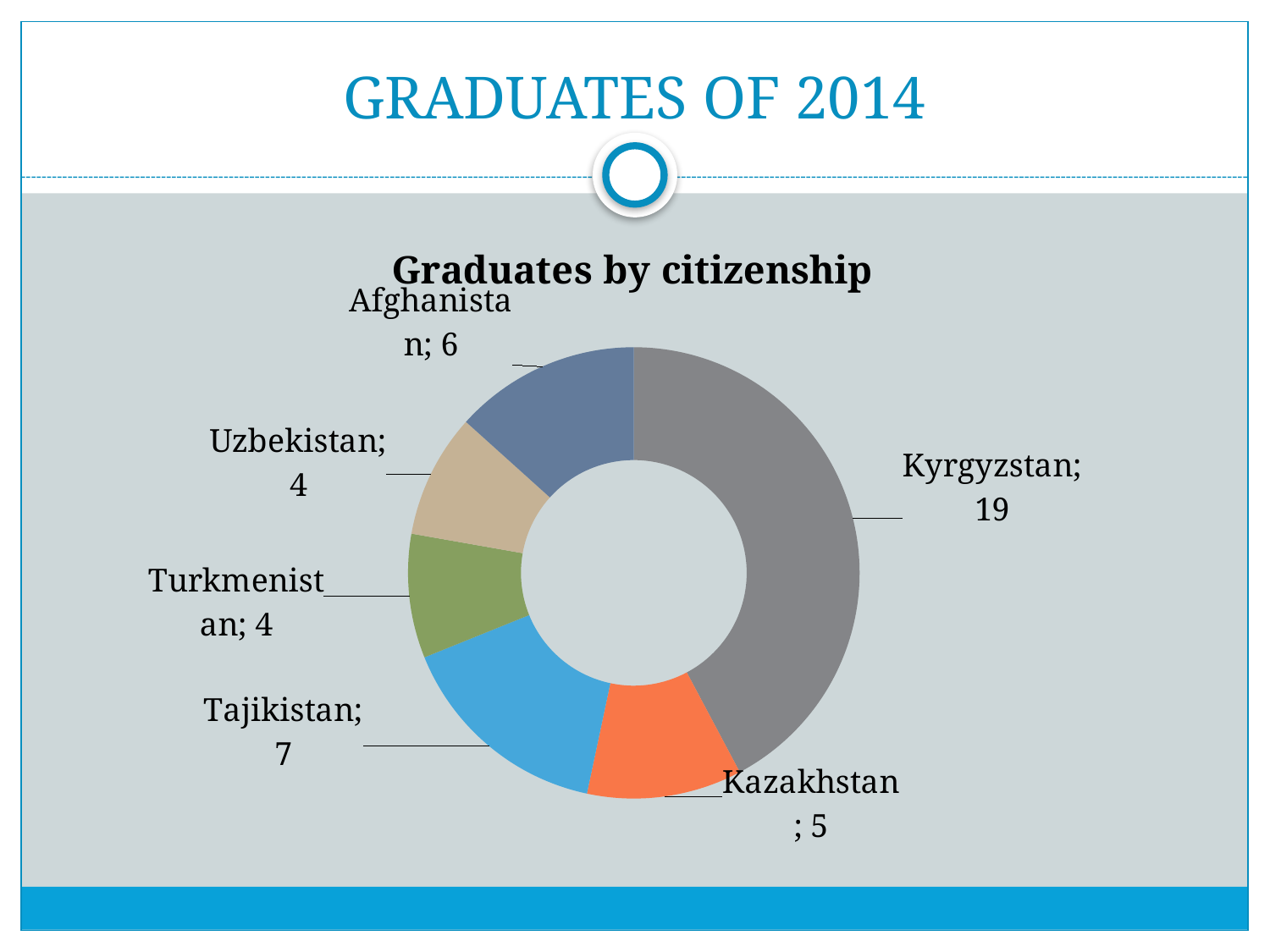
How many citizenship categories are shown in the chart? 6 What kind of chart is used to show graduates by citizenship? doughnut chart Which citizenship has the largest number of graduates in the chart? Kyrgyzstan Which has more graduates, Tajikistan or Kazakhstan? Tajikistan Which citizenships share the smallest value in the Graduates by citizenship chart? Turkmenistan and Uzbekistan What is the title of the chart on the slide? Graduates by citizenship What is the value for Tajikistan in the Graduates by citizenship chart? 7 How many graduates from Kyrgyzstan are shown in the Graduates by citizenship chart? 19 What is the difference between the number of graduates from Kyrgyzstan and from Tajikistan? 12 What is the difference between the values for Afghanistan and Kazakhstan? 1 What is the value for Kazakhstan in the Graduates by citizenship chart? 5 What is the value for Afghanistan in the Graduates by citizenship chart? 6